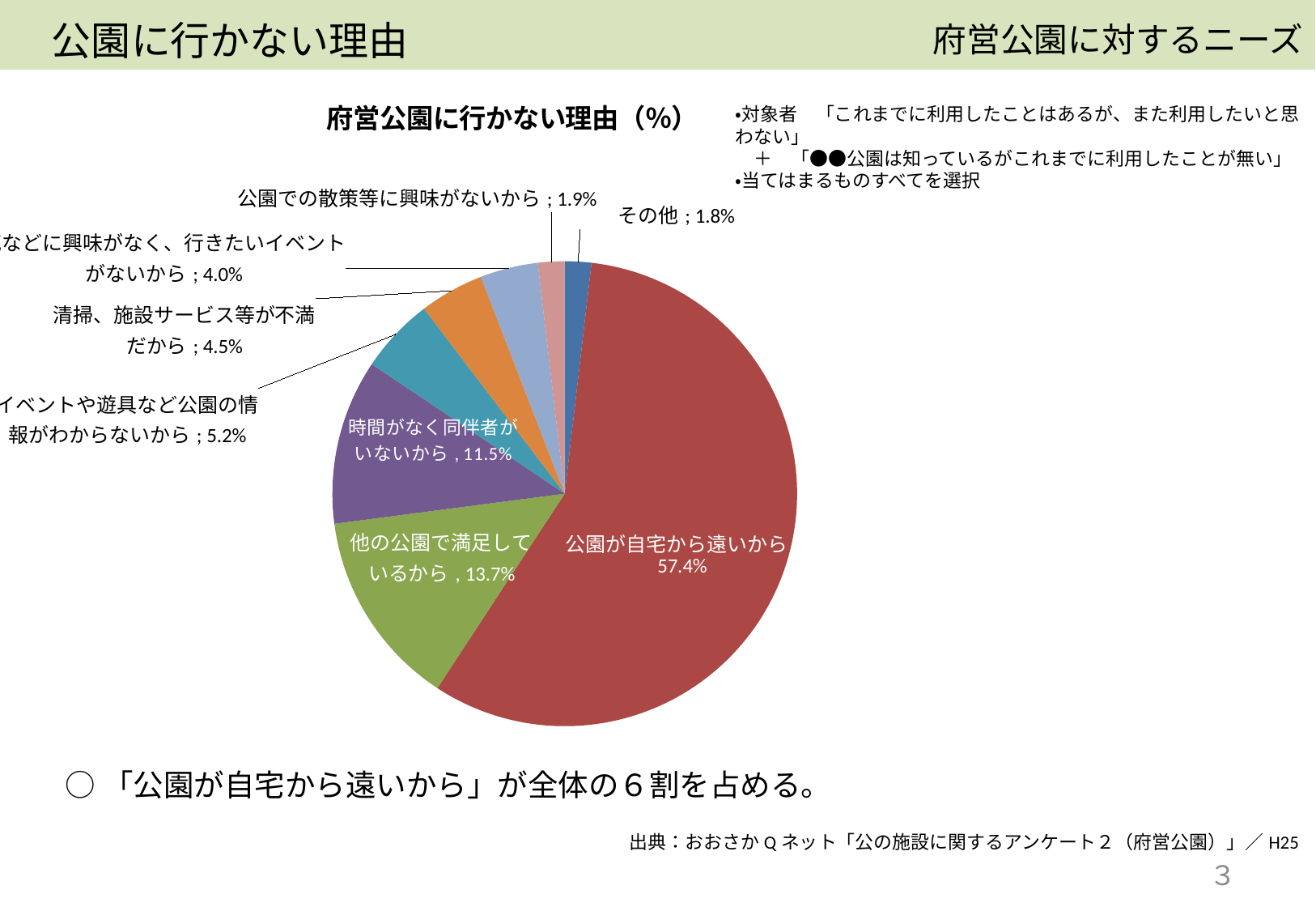
最も割合が小さい理由はどれですか？ その他 「他の公園で満足しているから」と「時間がなく同伴者がいないから」の割合の差は何ポイントですか？ 2.2 「他の公園で満足しているから」の割合は何%ですか？ 13.7% 「清掃、施設サービス等が不満だから」と「公園での散策等に興味がないから」では、どちらの割合が大きいですか？ 清掃、施設サービス等が不満だから 「清掃、施設サービス等が不満だから」の割合は何%ですか？ 4.5% 最も割合が大きい理由はどれですか？ 公園が自宅から遠いから 「その他」の割合は何%ですか？ 1.8% 「公園が自宅から遠いから」の割合は何%ですか？ 57.4% この円グラフには何個の項目（スライス）がありますか？ 8 「時間がなく同伴者がいないから」の割合は何%ですか？ 11.5% 「イベントや遊具など公園の情報がわからないから」の割合は何%ですか？ 5.2% このグラフの種類は何ですか？ 円グラフ